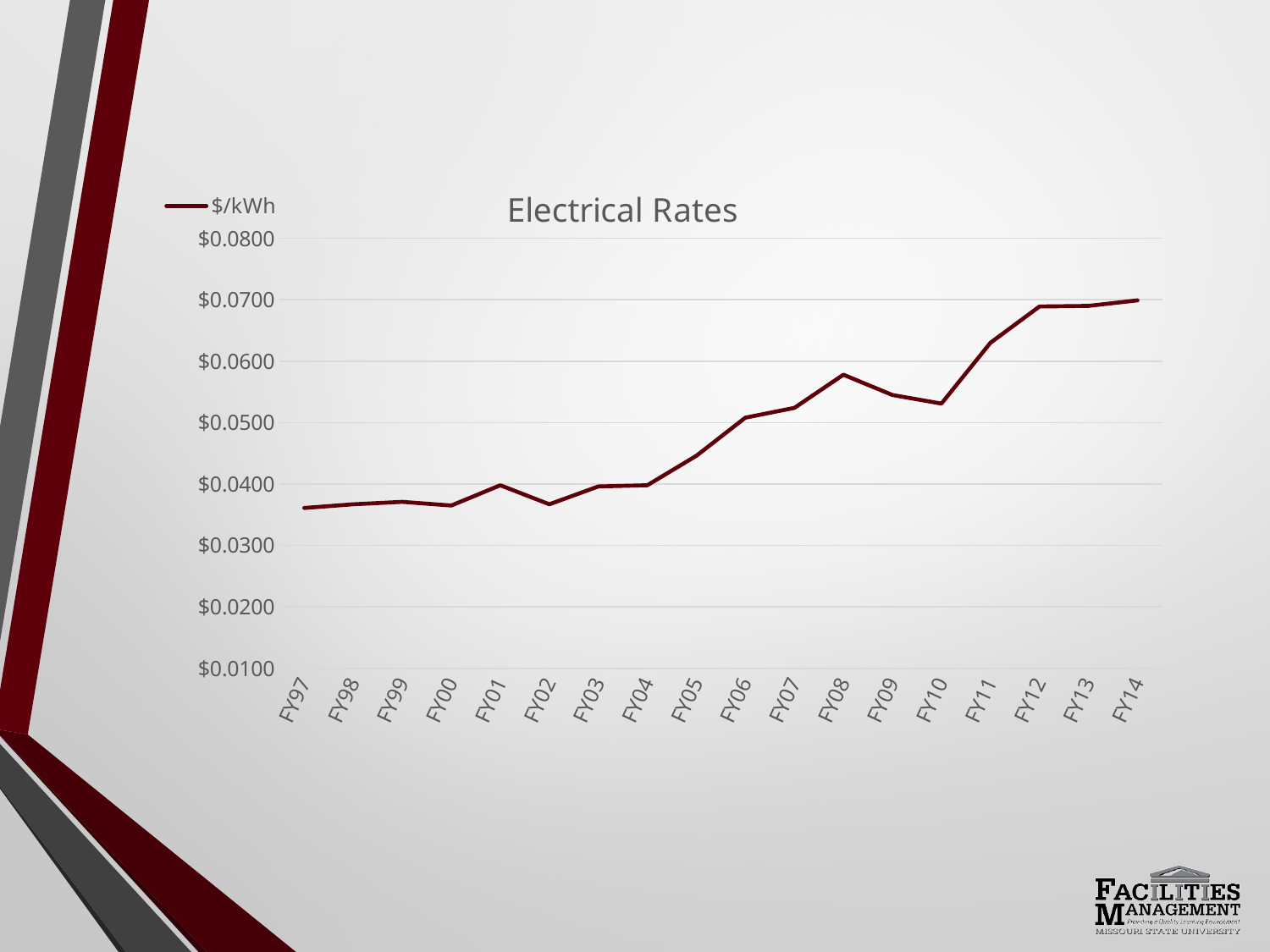
Is the value for FY11 greater or less than $0.0600? greater What is the title of the chart? Electrical Rates Do the electrical rates generally rise or fall from FY97 to FY14? rise How many series does the legend list? 1 Which has the higher electrical rate, FY08 or FY10? FY08 Is the value for FY14 greater or less than $0.0800? less What kind of chart is shown on the slide? line chart Is the value for FY08 greater or less than $0.0500? greater What series name does the legend show? $/kWh Which has the higher electrical rate, FY05 or FY11? FY11 How many fiscal years are plotted along the x axis? 18